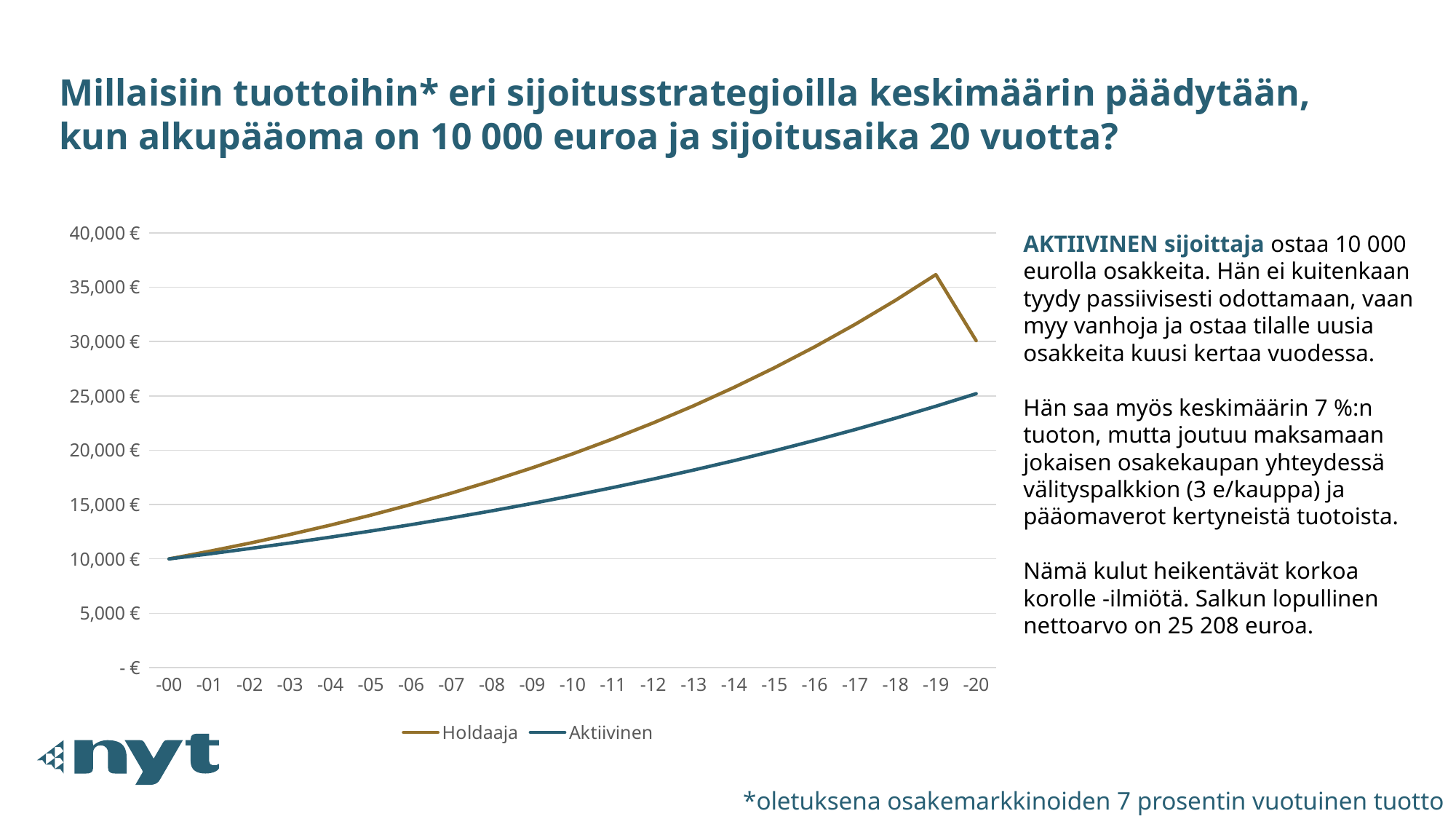
How many series does the legend list? 2 Is the value for Holdaaja at -19 greater or less than 35,000 €? greater Between -19 and -20, does the Holdaaja line rise or fall? fall What are the two series named in the legend? Holdaaja and Aktiivinen How many points are marked along the x axis (from -00 to -20)? 21 What is the value of both series at -00? 10,000 € What kind of chart is shown on the slide? line chart Is the value for Holdaaja at -15 greater or less than 25,000 €? greater Is the value for Aktiivinen at -10 greater or less than 15,000 €? greater Which series has the higher value at -19, Holdaaja or Aktiivinen? Holdaaja Does the Aktiivinen line rise or fall from -00 to -20? rise